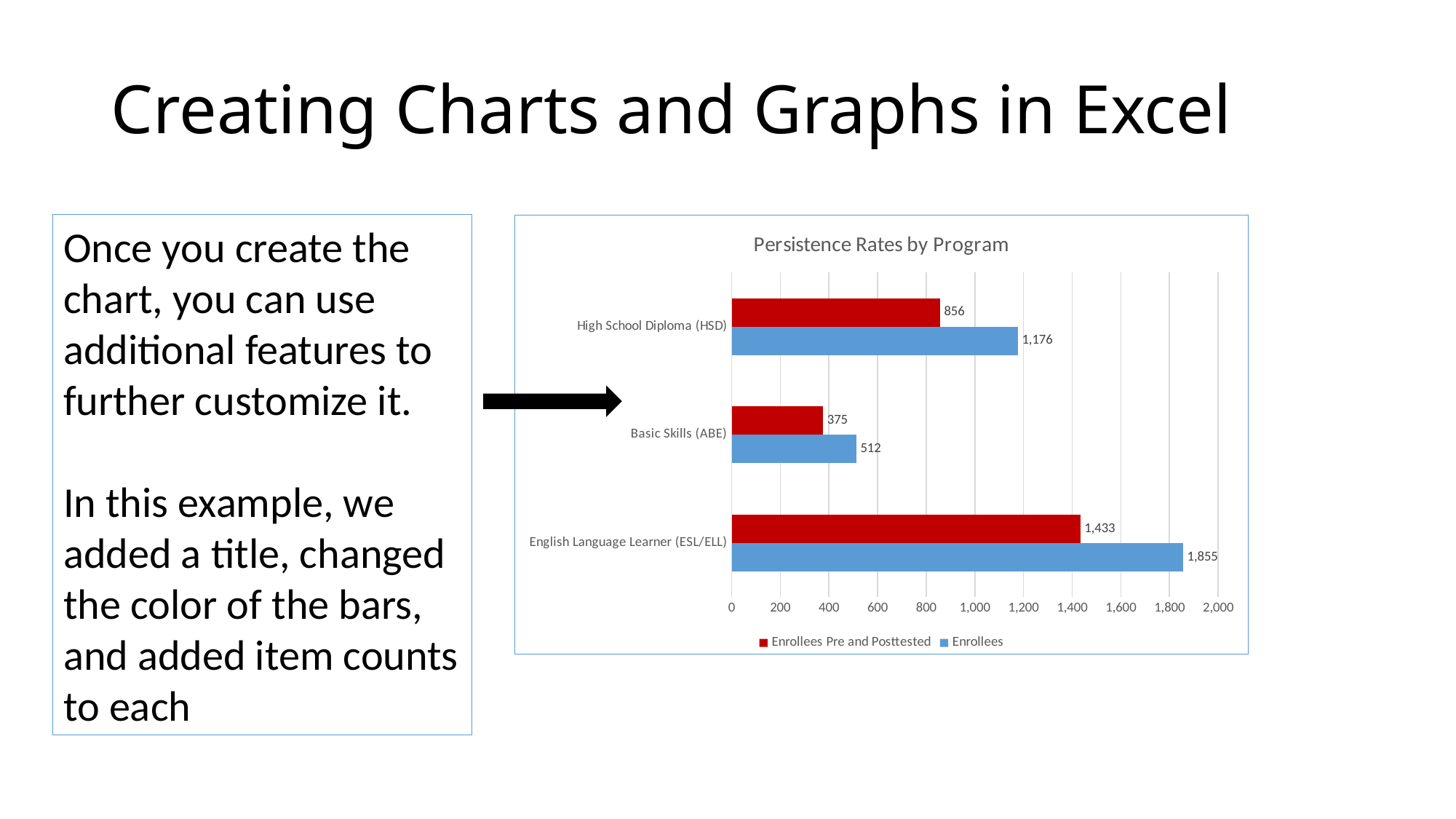
What is the value of Enrollees for High School Diploma (HSD)? 1,176 How many series does the legend list? 2 Which program has the lowest number of Enrollees Pre and Posttested? Basic Skills (ABE) How many programs are shown on the chart? 3 What kind of chart is shown on the slide? Bar chart What is the difference between Enrollees and Enrollees Pre and Posttested for High School Diploma (HSD)? 320 What is the value of Enrollees Pre and Posttested for Basic Skills (ABE)? 375 What is the value of Enrollees for English Language Learner (ESL/ELL)? 1,855 What is the difference between Enrollees and Enrollees Pre and Posttested for English Language Learner (ESL/ELL)? 422 What is the title of the chart? Persistence Rates by Program Which program has the highest number of Enrollees? English Language Learner (ESL/ELL) Which is larger: Enrollees for Basic Skills (ABE) or Enrollees Pre and Posttested for High School Diploma (HSD)? Enrollees Pre and Posttested for High School Diploma (HSD)